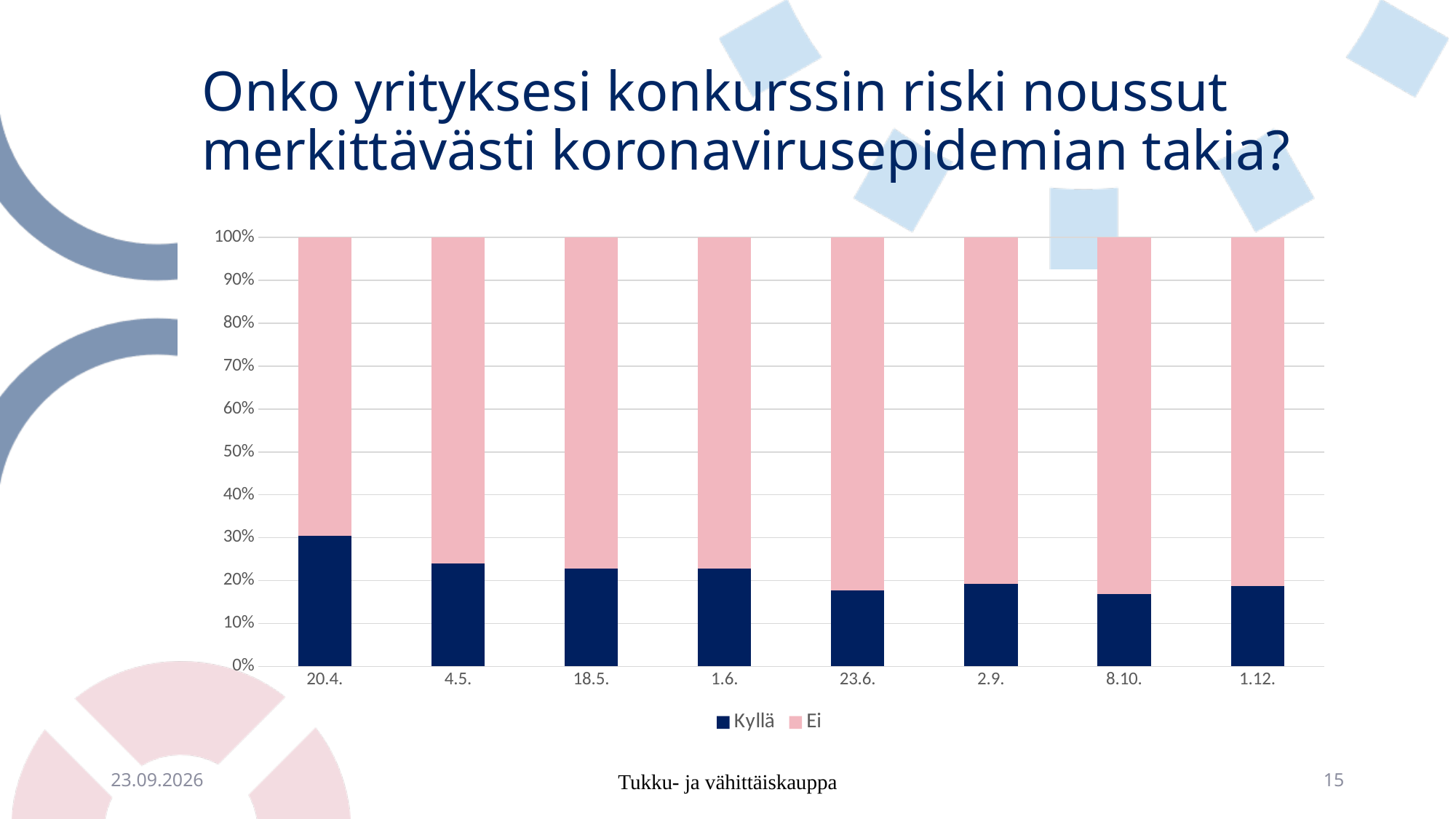
What are the two series named in the legend? Kyllä and Ei Is the Ei value for 20.4. greater or less than 80%? less What kind of chart is shown on the slide? stacked bar chart Is the Kyllä value for 20.4. greater or less than 20%? greater Which has a larger Kyllä share, 4.5. or 2.9.? 4.5. Does the Kyllä share generally rise or fall from 20.4. to 1.12.? fall Is the Kyllä value for 23.6. greater or less than 20%? less How many dates (categories) are shown on the x axis? 8 How many series does the legend list? 2 What is the total of each stacked bar? 100% Which has a larger Kyllä share, 20.4. or 4.5.? 20.4. On which date is the Kyllä share the highest? 20.4.